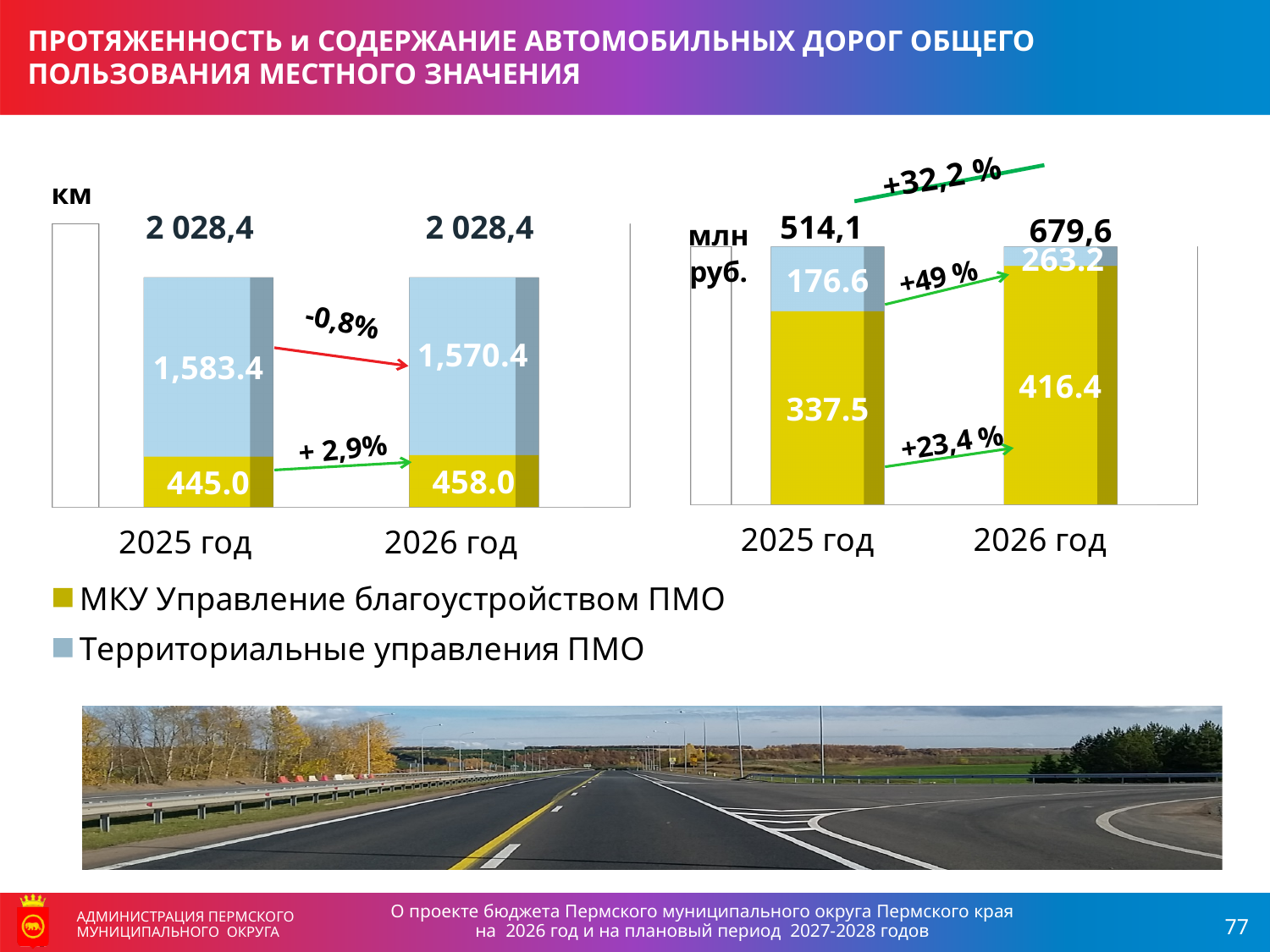
In the left chart (km), what is the value for МКУ Управление благоустройством ПМО in 2025 год? 445.0 In the left chart (km), what is the value for Территориальные управления ПМО in 2026 год? 1,570.4 What type of chart is used on the slide? Stacked bar chart In the right chart (млн руб.), what is the difference between the МКУ Управление благоустройством ПМО values for 2026 год and 2025 год? 78.9 In the right chart (млн руб.), what is the total shown for 2025 год? 514,1 In the left chart (km), which is larger in 2025 год: Территориальные управления ПМО or МКУ Управление благоустройством ПМО? Территориальные управления ПМО In the left chart (km), what is the total length shown for 2026 год? 2 028,4 How many series does the legend list? 2 In the right chart (млн руб.), which year has the higher total? 2026 год In the right chart (млн руб.), what is the value for Территориальные управления ПМО in 2025 год? 176.6 In the right chart (млн руб.), what is the value for МКУ Управление благоустройством ПМО in 2026 год? 416.4 In the right chart (млн руб.), what percentage change is shown for the total from 2025 год to 2026 год? +32,2 %